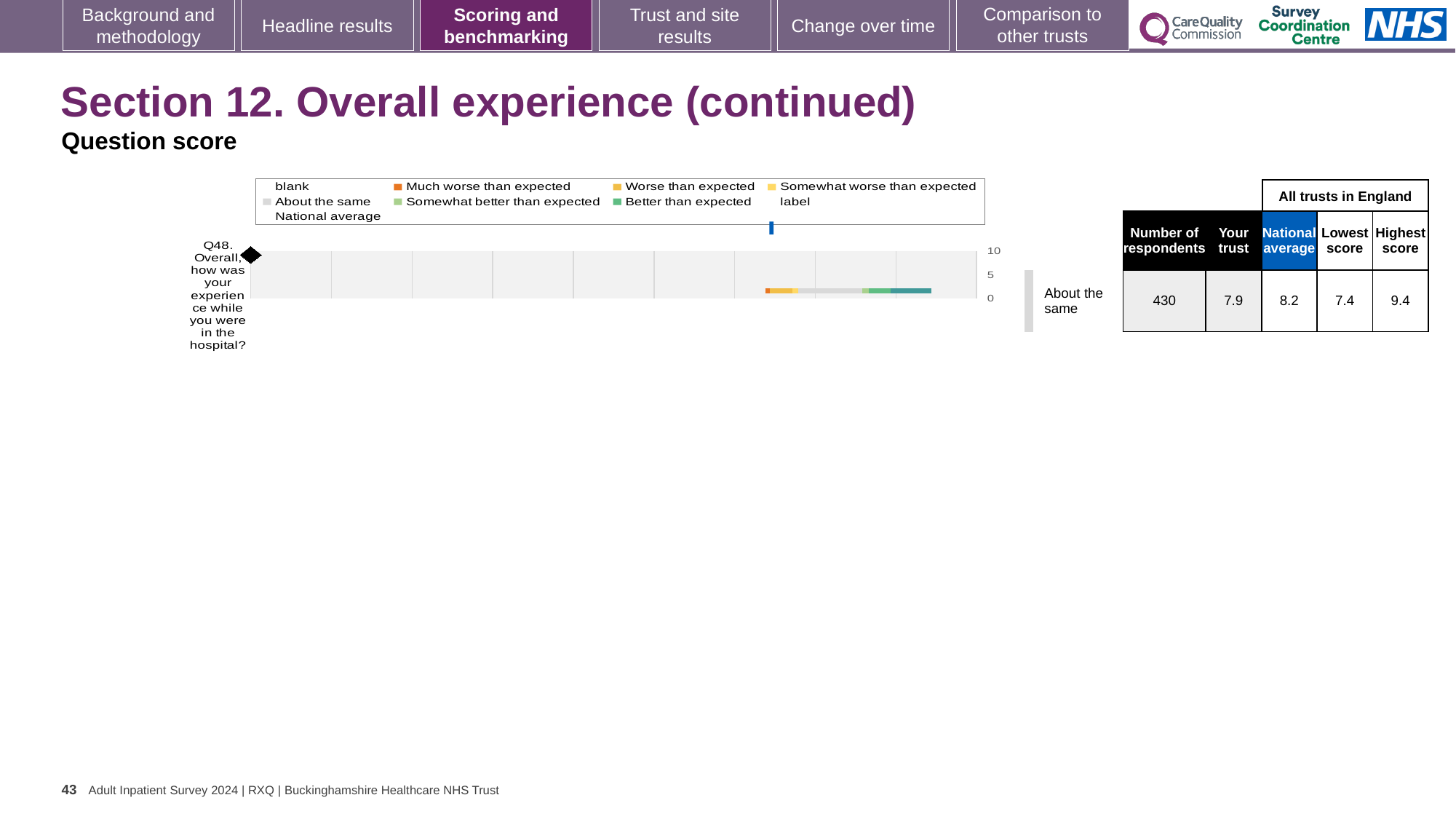
Is the national average marker on the Q48 chart greater or less than 5? greater In the table beside the chart, what is the national average score for Q48? 8.2 Which colour in the chart legend represents 'About the same'? grey What kind of chart is shown on the slide for Q48? bar chart In the table beside the chart, what is the number of respondents for Q48? 430 Which colour in the chart legend represents 'Much worse than expected'? orange Which is larger for Q48: the 'Your trust' score or the national average? National average In the table beside the chart, what is the 'Your trust' score for Q48? 7.9 What is the difference between the highest score (9.4) and the lowest score (7.4) for Q48? 2.0 How many questions (categories) are plotted in the chart? 1 In the table beside the chart, what is the highest score among all trusts in England for Q48? 9.4 Which benchmarking category is the trust's Q48 result labelled as next to the chart? About the same